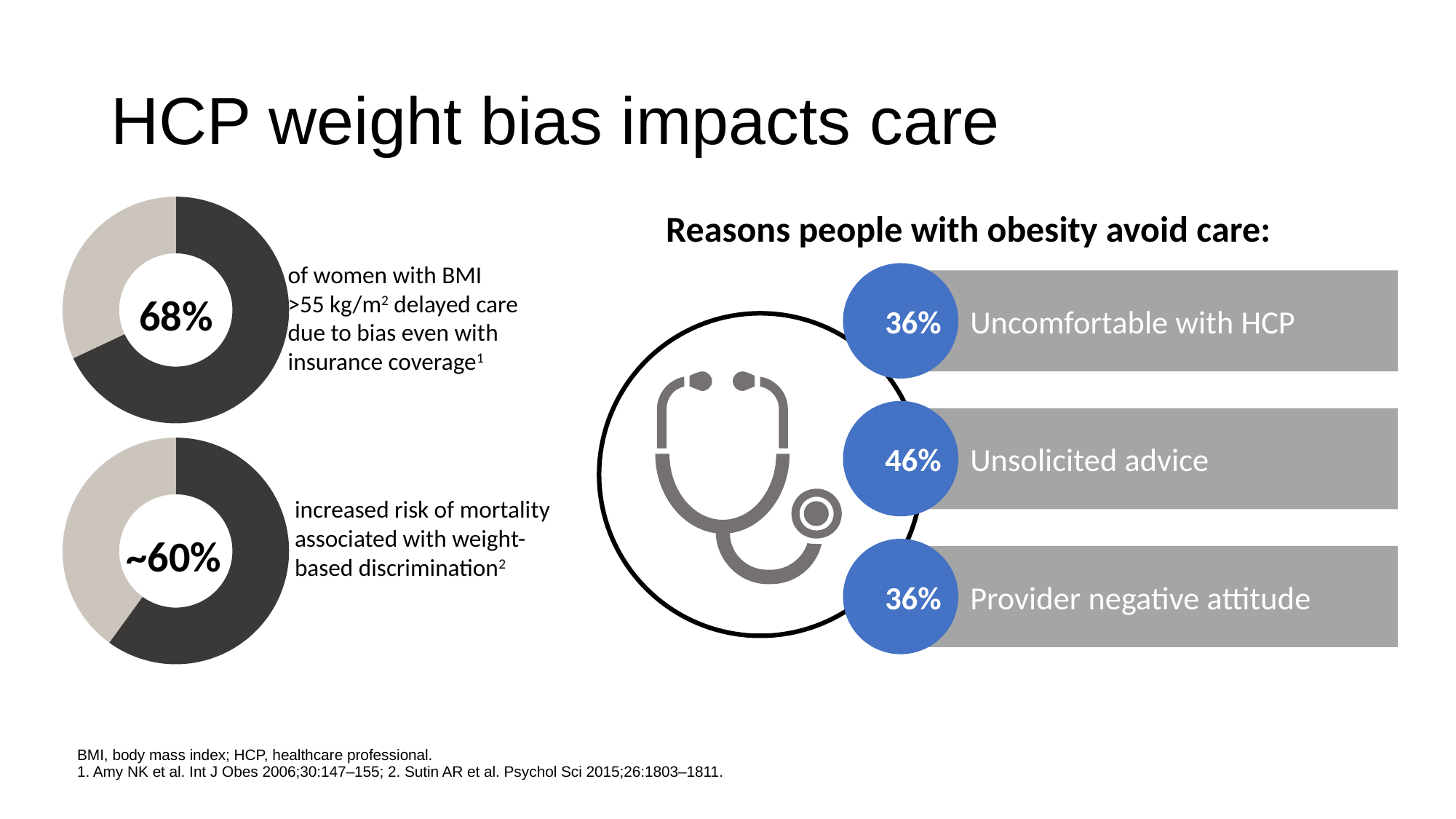
What value is shown in the centre of the bottom donut chart on the left of the slide? ~60% In the 'Reasons people with obesity avoid care' graphic, which reason has the highest percentage? Unsolicited advice In the 'Reasons people with obesity avoid care' graphic, what percentage is given for 'Provider negative attitude'? 36% What is the title of the graphic on the right side of the slide? Reasons people with obesity avoid care: In the 'Reasons people with obesity avoid care' graphic, what percentage is given for 'Unsolicited advice'? 46% In the top donut chart, is the dark segment greater or less than 50%? greater What percentage is shown in the centre of the top donut chart on the left of the slide? 68% In the 'Reasons people with obesity avoid care' graphic, what is the difference in percentage points between 'Unsolicited advice' and 'Uncomfortable with HCP'? 10 percentage points In the 'Reasons people with obesity avoid care' graphic, which is larger: 'Unsolicited advice' or 'Provider negative attitude'? Unsolicited advice What kind of chart are the two charts on the left of the slide? Donut (pie) charts In the 'Reasons people with obesity avoid care' graphic, what percentage is given for 'Uncomfortable with HCP'? 36% How many reasons are listed in the 'Reasons people with obesity avoid care' graphic? 3